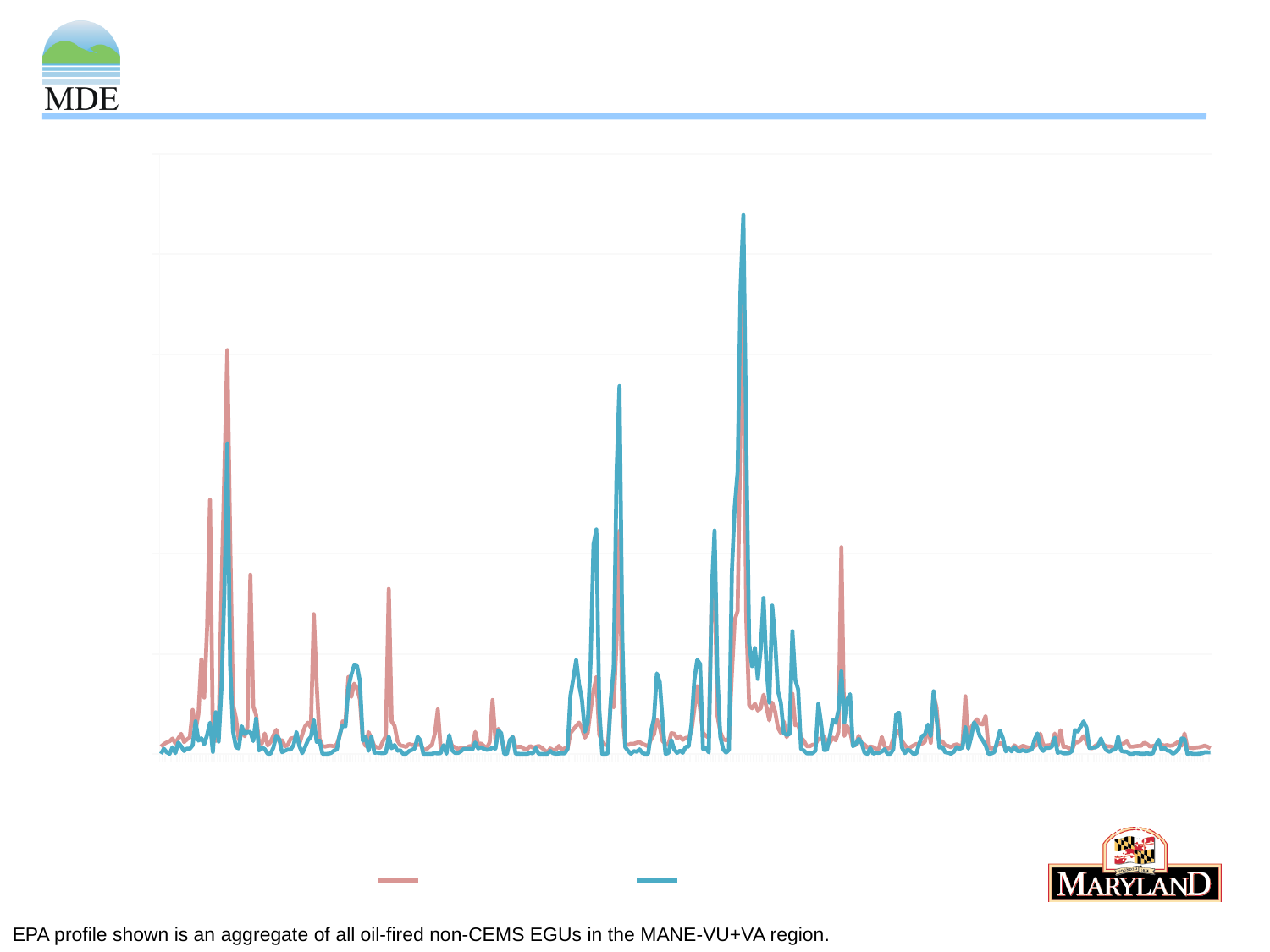
Which line reaches the highest peak on the chart, the pink line or the blue line? the blue line What kind of chart is shown on the slide? line chart Does the chart display a visible title above the plot area? No How many series does the chart's legend list? 2 What two colours are used for the lines on the chart? pink and blue